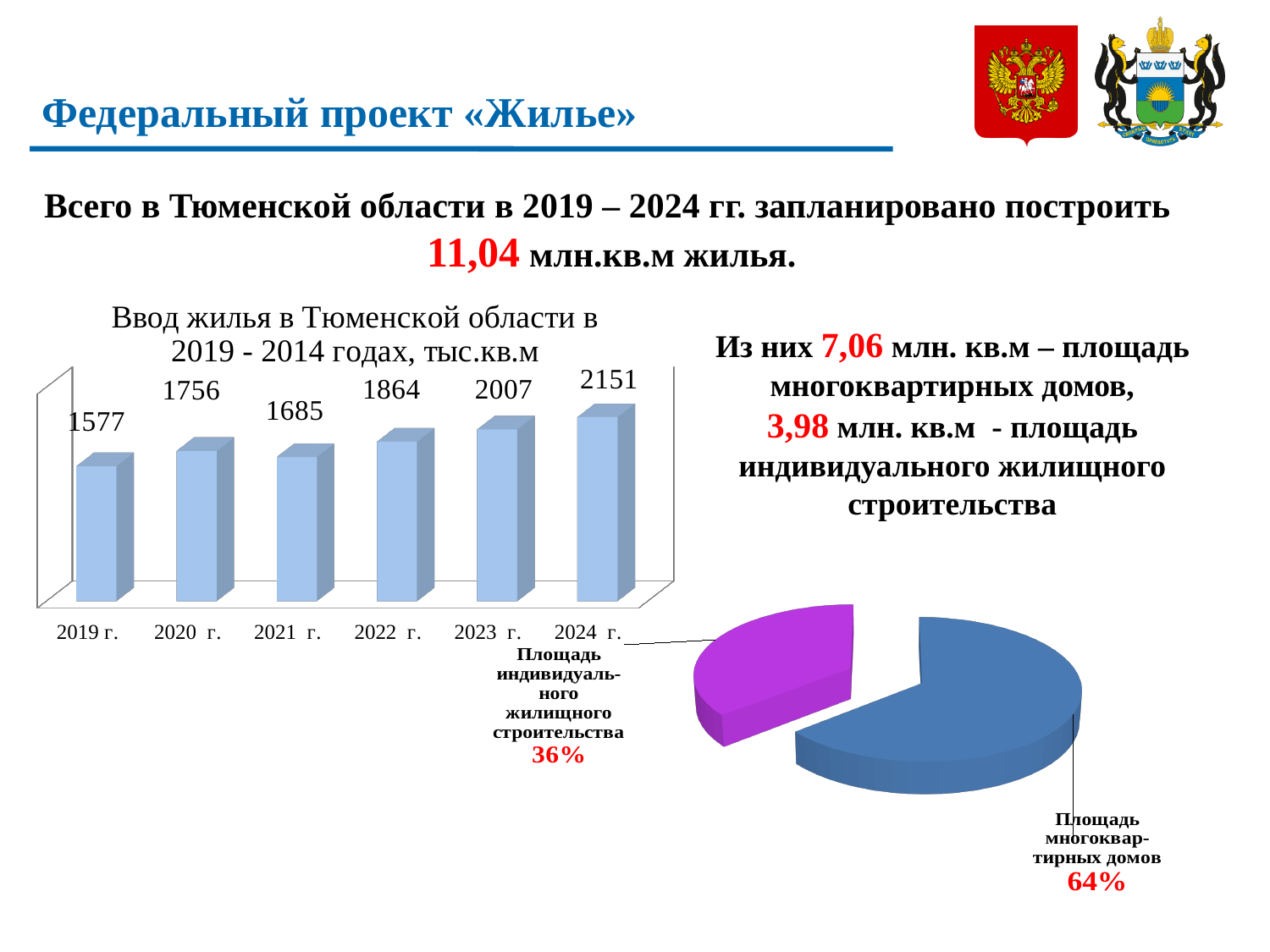
In the bar chart 'Ввод жилья в Тюменской области', which year has the lowest value? 2019 г. In the pie chart at the bottom of the slide, what share is labelled 'Площадь индивидуального жилищного строительства'? 36% In the bar chart 'Ввод жилья в Тюменской области', which is larger: the value for 2020 г. or 2021 г.? 2020 г. In the bar chart 'Ввод жилья в Тюменской области', do the values generally rise or fall from 2021 г. to 2024 г.? rise How many years (categories) are shown in the bar chart 'Ввод жилья в Тюменской области'? 6 In the bar chart 'Ввод жилья в Тюменской области', what is the value for 2022 г.? 1864 In the bar chart 'Ввод жилья в Тюменской области', what is the value for 2019 г.? 1577 What kind of chart is the chart titled 'Ввод жилья в Тюменской области'? bar chart In the bar chart 'Ввод жилья в Тюменской области', what is the difference between the values for 2024 г. and 2023 г.? 144 In the pie chart at the bottom of the slide, what share is labelled 'Площадь многоквартирных домов'? 64% What kind of chart is the chart at the bottom right of the slide showing 36% and 64%? pie chart In the bar chart 'Ввод жилья в Тюменской области', which year has the highest value? 2024 г.